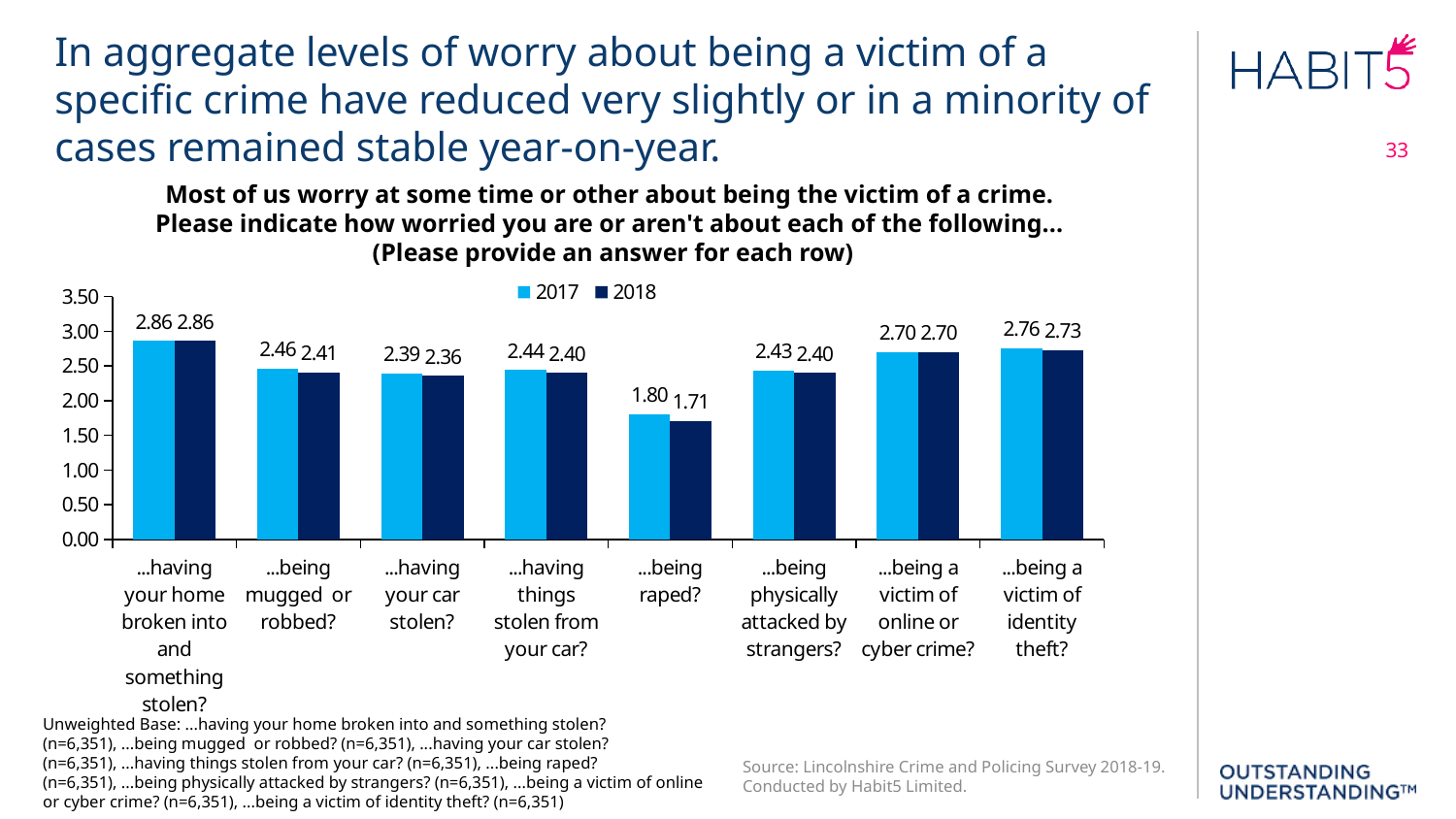
How many categories are shown on the x axis? 8 What is the 2017 value for '...having your home broken into and something stolen?' 2.86 What is the difference between the 2017 and 2018 values for '...being mugged or robbed?' 0.05 Which is larger: the 2017 value for '...being a victim of identity theft?' or the 2017 value for '...being a victim of online or cyber crime?' ...being a victim of identity theft? What kind of chart is shown on the slide? bar chart What is the 2018 value for '...being raped?' 1.71 Which category has the highest 2018 value? ...having your home broken into and something stolen? What is the difference between the 2017 and 2018 values for '...being raped?' 0.09 What is the 2018 value for '...being a victim of identity theft?' 2.73 Which category has the lowest 2017 value? ...being raped? How many series does the legend list? 2 Which two categories have the same value in 2017 and 2018? ...having your home broken into and something stolen? and ...being a victim of online or cyber crime?